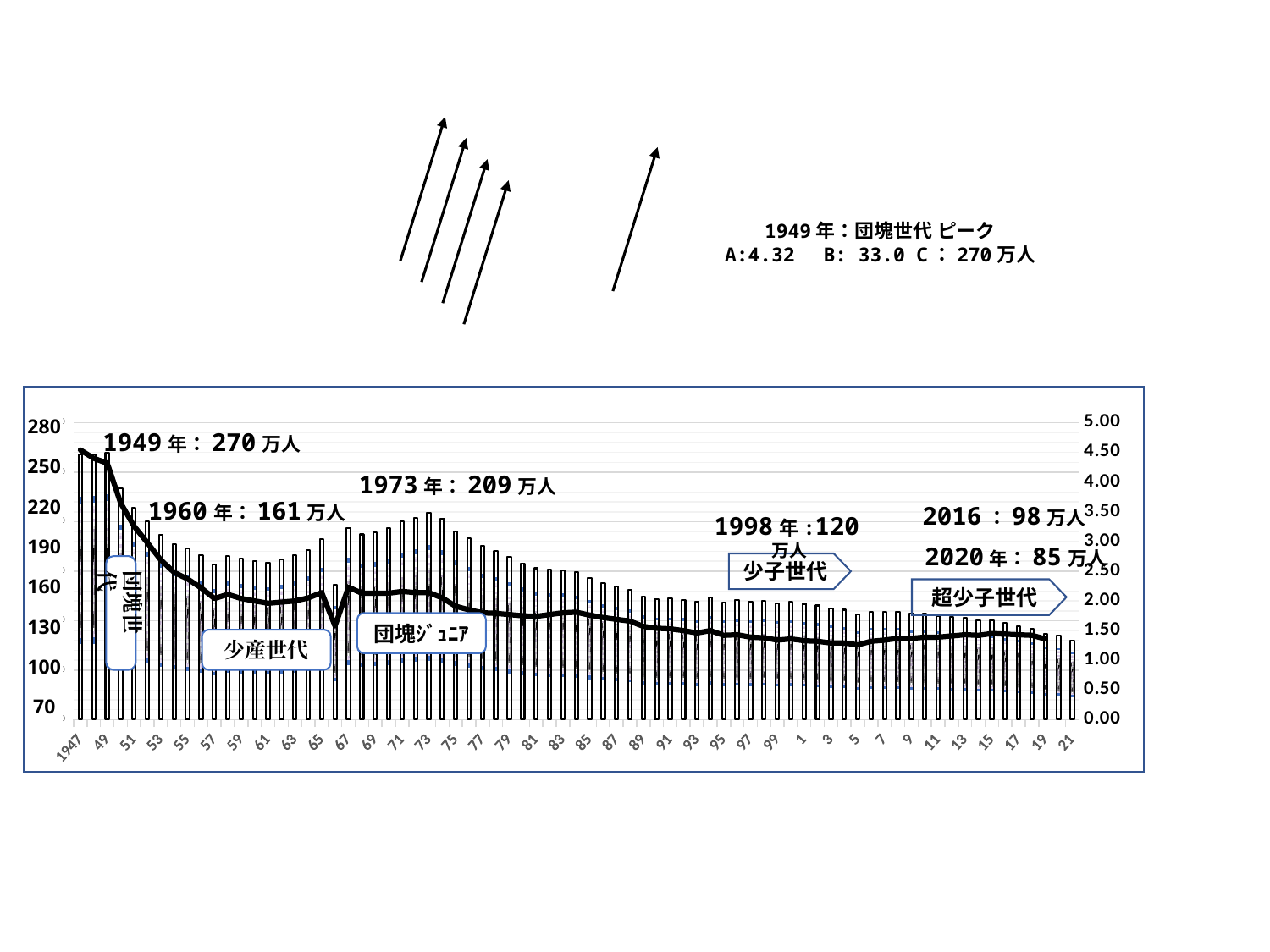
What is the difference between the annotated values for 1949 and 2020? 185万人 What value is annotated for 1973 on the chart? 209万人 What value is annotated for 2016 on the chart? 98万人 What value is annotated for 1949 on the chart? 270万人 Overall, do the bar values rise or fall from 1947 to 2021? fall What kinds of chart are combined on the slide? bar chart and line chart Which annotated value is larger, 1960 or 1973? 1973 Which year has the highest bar on the chart? 1949 What value is annotated for 1960 on the chart? 161万人 Is the bar value for 2021 greater or less than 100? less What value is annotated for 2020 on the chart? 85万人 What is the difference between the annotated values for 1949 and 1973? 61万人